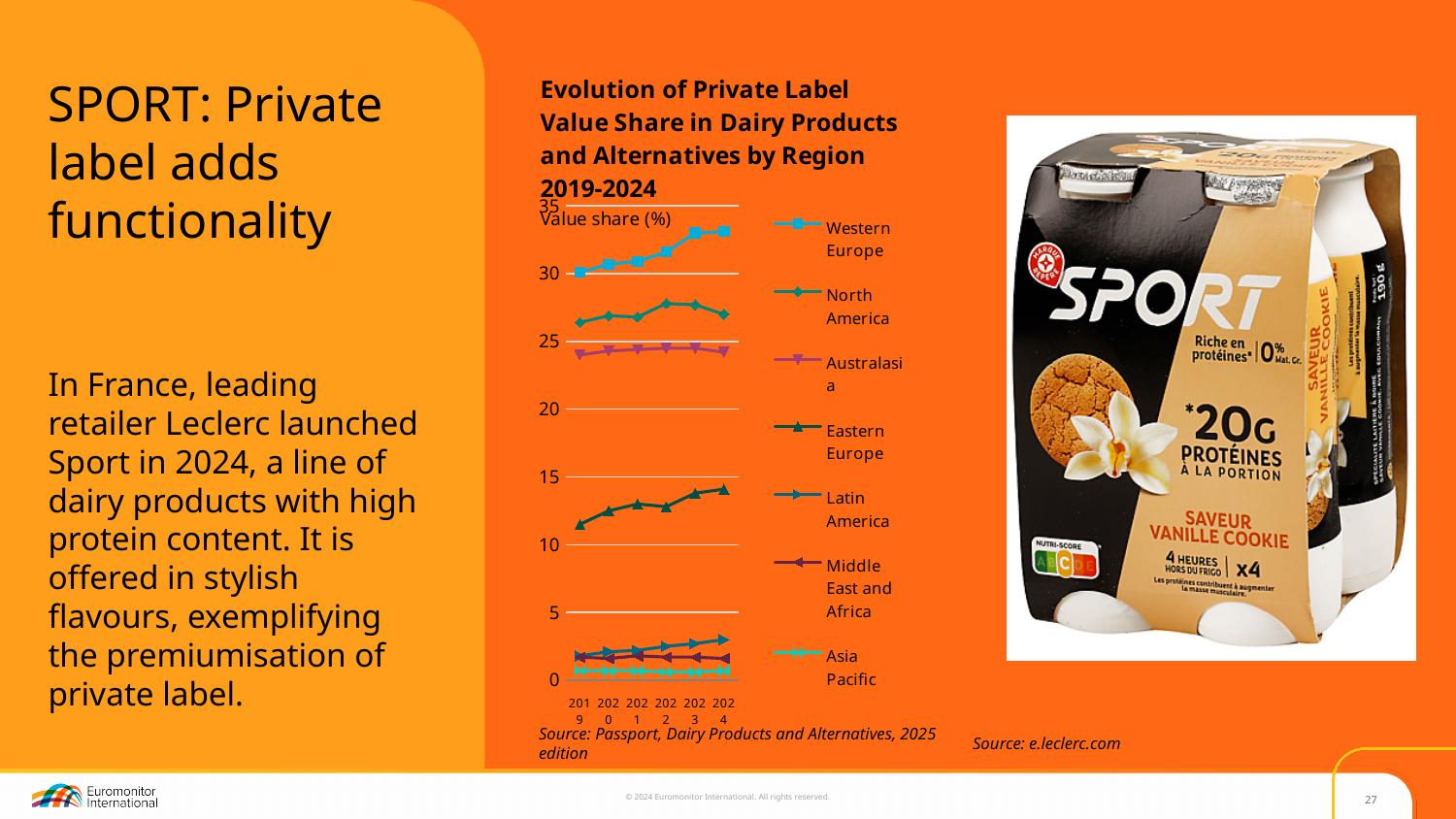
In 2024, which has the larger value share: Western Europe or North America? Western Europe Which region has the highest private label value share across the chart? Western Europe Does the value share for Western Europe rise or fall from 2019 to 2024? rise Is the value for Western Europe in 2024 greater or less than 30? greater How many series does the chart legend list? 7 What kind of chart is shown on the slide? line chart What is the title of the chart? Evolution of Private Label Value Share in Dairy Products and Alternatives by Region 2019-2024 Which region has the lowest private label value share across the chart? Asia Pacific Is the value for Eastern Europe in 2024 greater or less than 5? greater Does the value share for Latin America rise or fall from 2019 to 2024? rise How many years are plotted along the x axis of the chart? 6